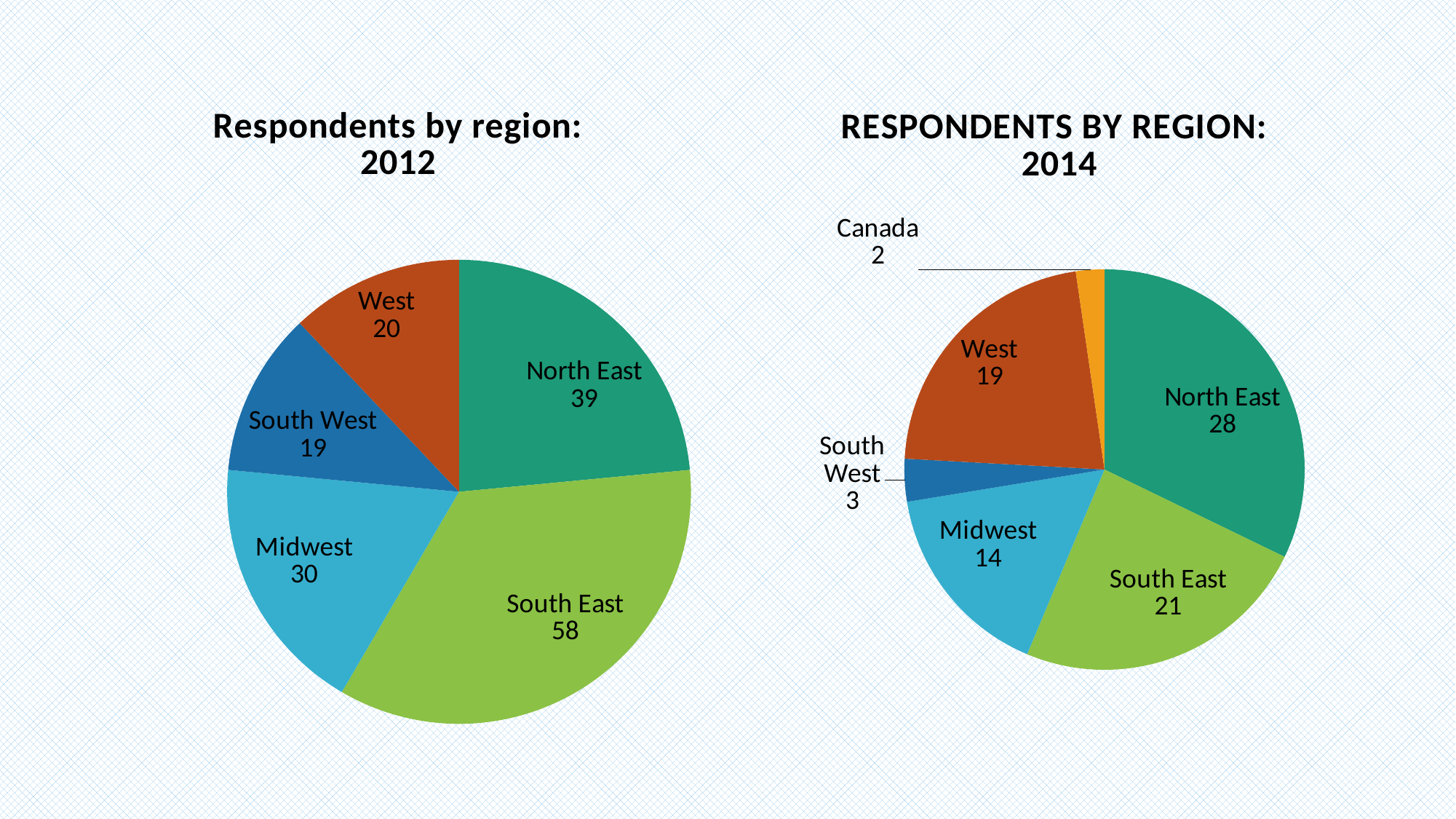
In the 'Respondents by region: 2014' chart, which region has the smallest slice? Canada How many regions are shown in the 'Respondents by region: 2014' chart? 6 In the 'Respondents by region: 2012' chart, what is the difference between the South East and North East values? 19 In the 'Respondents by region: 2012' chart, which region has the largest slice? South East In the 'Respondents by region: 2014' chart, how many respondents were from the Midwest? 14 In the 'Respondents by region: 2014' chart, what is the value for Canada? 2 In the 'Respondents by region: 2012' chart, which is larger, Midwest or West? Midwest How many regions are shown in the 'Respondents by region: 2012' chart? 5 In the 'Respondents by region: 2012' chart, how many respondents were from the South East? 58 What type of chart is used for 'Respondents by region: 2012'? Pie chart In the 'Respondents by region: 2014' chart, what is the difference between the North East and South East values? 7 In the 'Respondents by region: 2014' chart, which region has the largest slice? North East